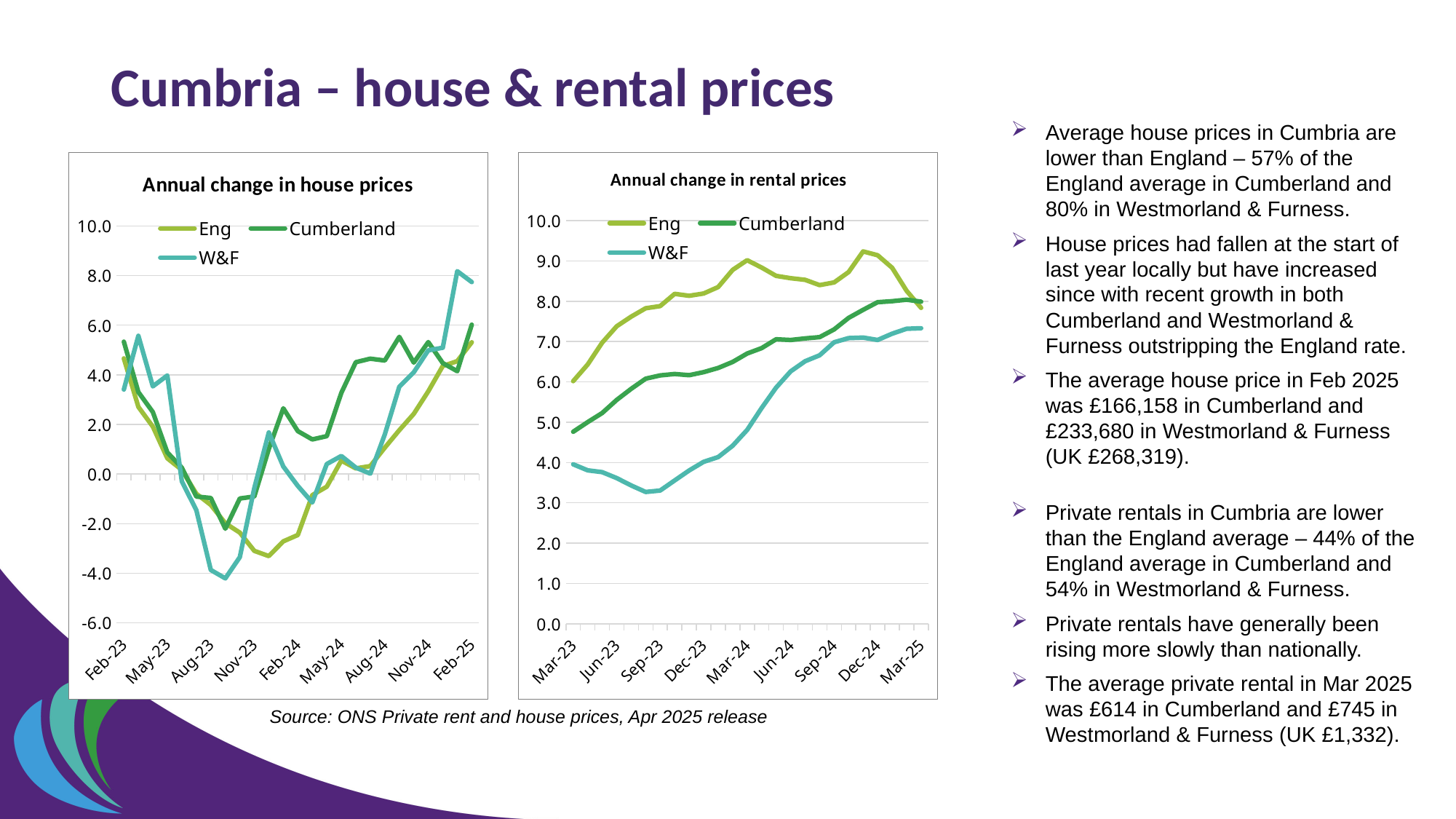
In the 'Annual change in rental prices' chart, which is larger at Mar-23: the value for Eng or the value for W&F? Eng In the 'Annual change in rental prices' chart, which series has the highest value at Dec-24? Eng In the 'Annual change in rental prices' chart, is the value for Eng at Dec-24 greater or less than 8.0? greater In the 'Annual change in rental prices' chart, is the value for W&F at Sep-23 greater or less than 4.0? less In the 'Annual change in house prices' chart, is the value for W&F at Feb-25 greater or less than 6.0? greater What kind of chart is the 'Annual change in house prices' chart? line chart In the 'Annual change in house prices' chart, do the Eng values rise or fall between Feb-23 and Aug-23? fall How many series does the legend of the 'Annual change in rental prices' chart list? 3 In the 'Annual change in rental prices' chart, do the W&F values rise or fall overall from Mar-23 to Mar-25? rise In the 'Annual change in rental prices' chart, which series has the lowest value at Sep-23? W&F In the 'Annual change in house prices' chart, which series are listed in the legend? Eng, Cumberland, W&F